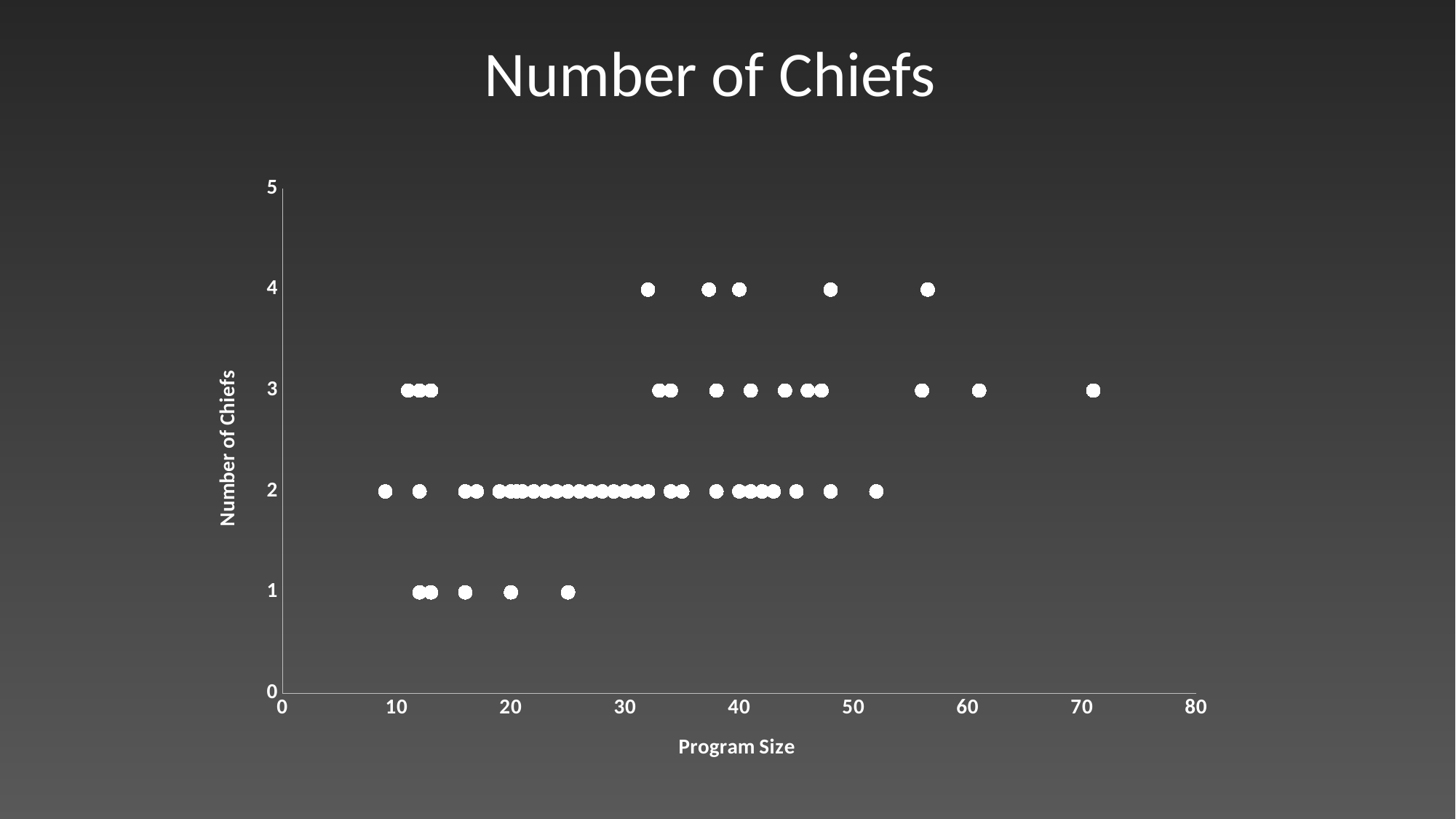
How many points are plotted at 4 chiefs? 5 Is the program size of the rightmost point at 4 chiefs greater or less than 50? greater How many chiefs does the program with the largest program size have? 3 What is the title of the chart? Number of Chiefs What is the highest number of chiefs plotted for any program? 4 What is the label of the x axis? Program Size What is the lowest number of chiefs plotted for any program? 1 Which has more plotted points: 2 chiefs or 3 chiefs? 2 chiefs Is the program size of the leftmost point greater or less than 10? less What kind of chart is shown on the slide? scatter chart Is the program size of the rightmost point greater or less than 70? greater